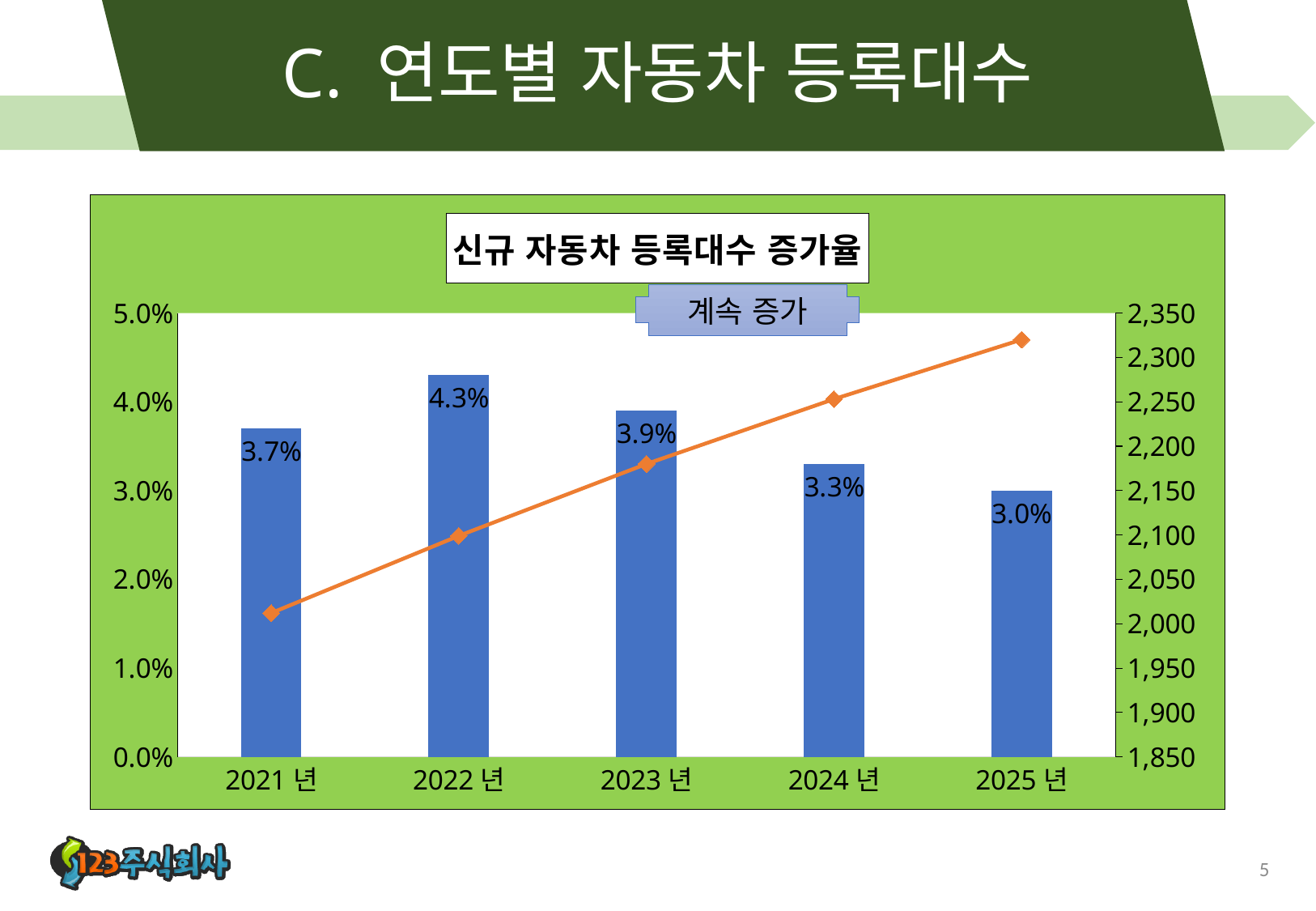
What is the difference between the growth rates for 2022 년 and 2024 년? 1.0% What is the growth rate shown for 2025 년? 3.0% Does the orange line rise or fall from 2021 년 to 2025 년? rise Which year has the lowest growth rate bar? 2025 년 Is the value of the line point for 2023 년 on the right axis greater or less than 2,200? less Is the value of the line point for 2025 년 on the right axis greater or less than 2,300? greater Which year has the highest growth rate bar? 2022 년 Which is larger, the growth rate for 2021 년 or for 2023 년? 2023 년 How many years are shown on the x axis? 5 What is the growth rate shown for 2021 년? 3.7% What is the growth rate shown for 2022 년? 4.3% What is the title of the chart? 신규 자동차 등록대수 증가율